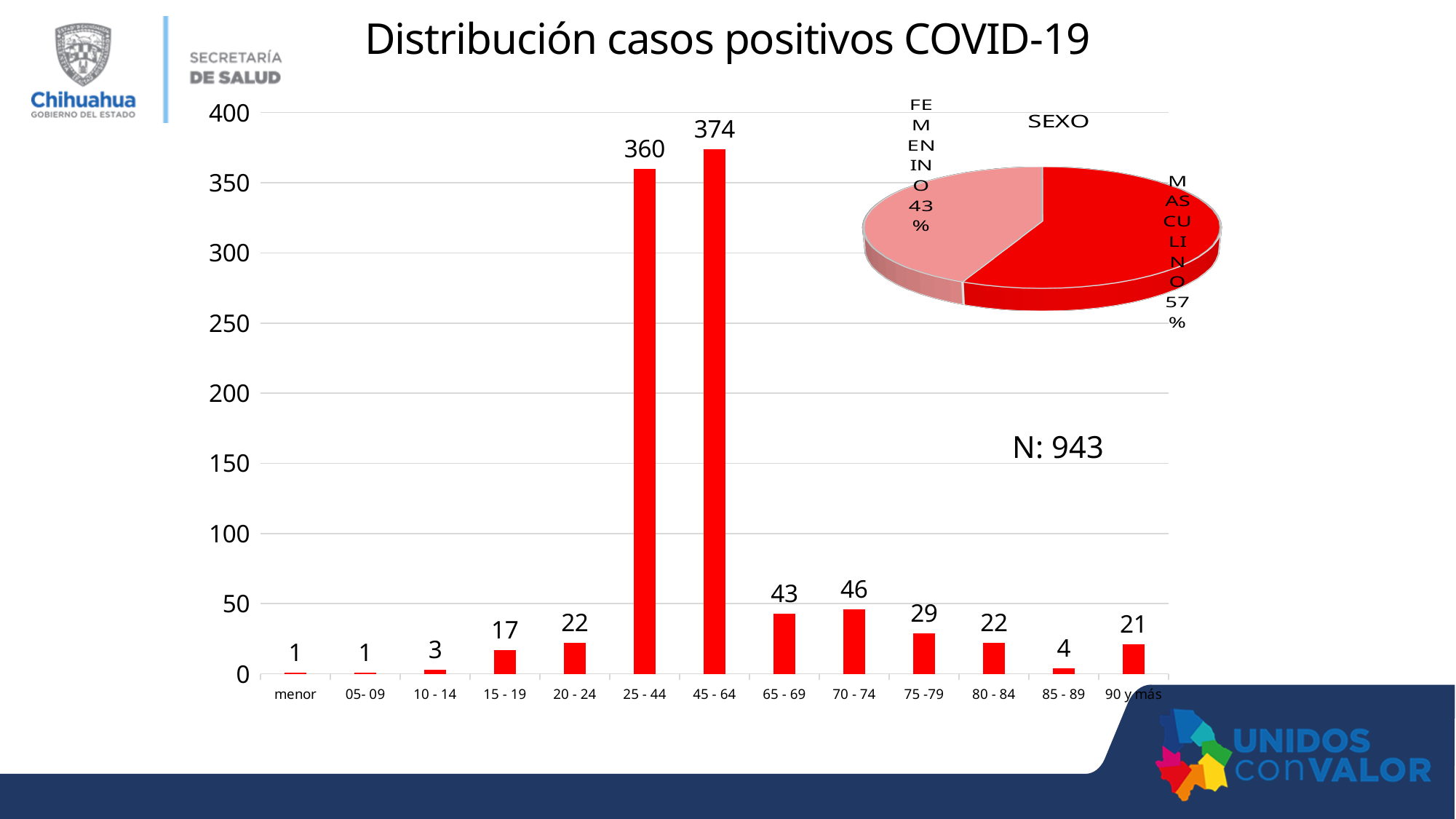
In the bar chart, which is larger, the value for 65 - 69 or the value for 70 - 74? 70 - 74 In the SEXO pie chart, what share is labelled FEMENINO? 43% What kind of chart is the large chart on the left of the slide? Bar chart In the bar chart, how many age-group categories are shown on the x axis? 13 In the bar chart, what is the value for the 25 - 44 age group? 360 In the bar chart, which age group has the highest value? 45 - 64 In the bar chart, what is the difference between the 45 - 64 and 25 - 44 age groups? 14 In the bar chart, what is the value for the 45 - 64 age group? 374 In the SEXO pie chart, what share is labelled MASCULINO? 57% In the bar chart, what is the value for the 85 - 89 age group? 4 In the bar chart, what is the value for the 70 - 74 age group? 46 In the bar chart, what is the difference between the 75 -79 and 80 - 84 age groups? 7